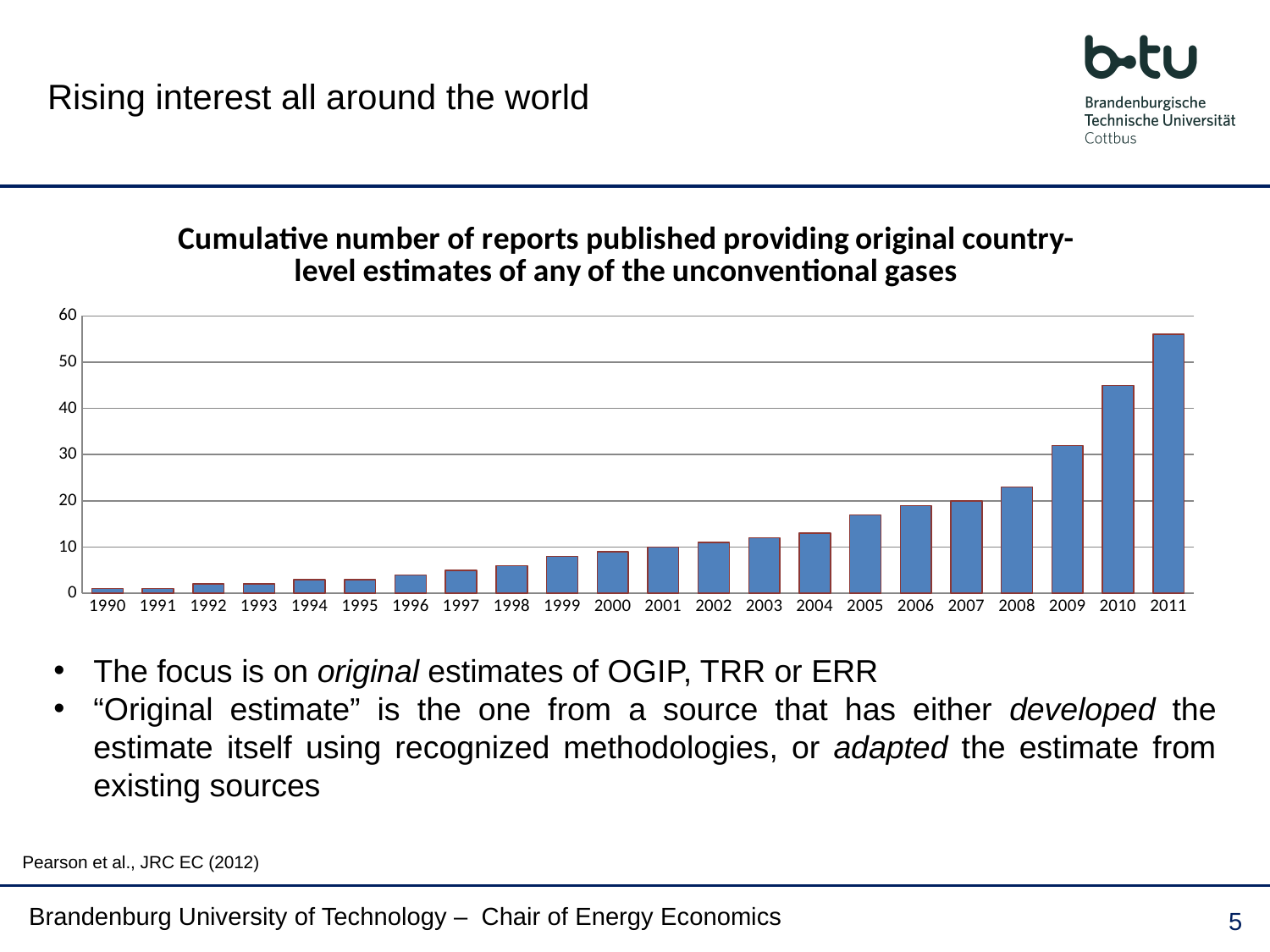
Is the value for 2009 greater or less than 30? greater What is the title of the chart? Cumulative number of reports published providing original country-level estimates of any of the unconventional gases Is the value for 2011 greater or less than 50? greater Do the values rise or fall from 1990 to 2011? rise Which year has the highest cumulative number of reports? 2011 Is the value for 2004 greater or less than 10? greater Which is larger, the value for 2009 or the value for 2010? 2010 How many years are shown on the x axis of the chart? 22 What kind of chart is shown on the slide? bar chart